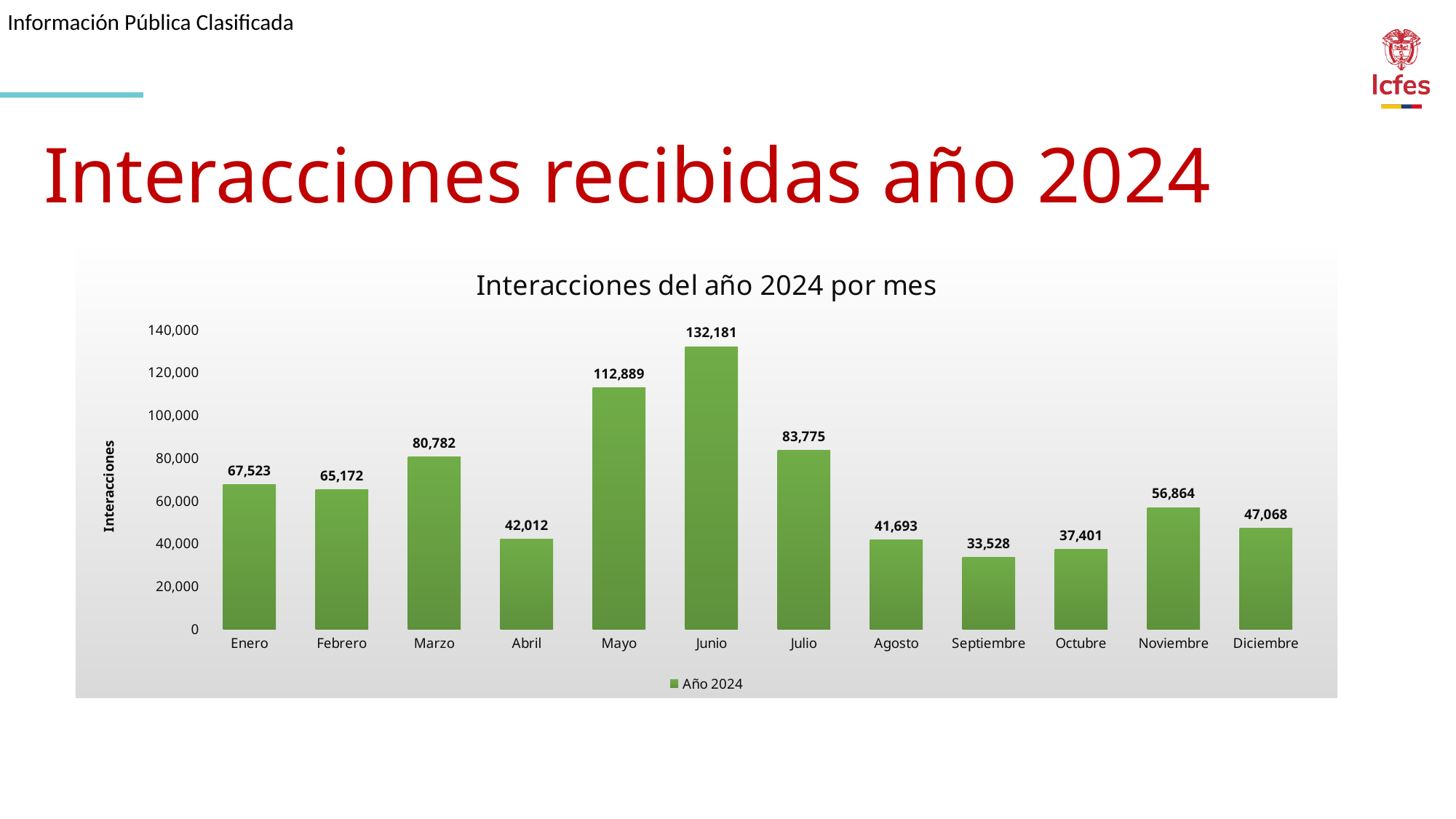
Which month has the lowest value? Septiembre What is the difference between the values for Junio and Mayo? 19,292 How many months are shown on the x axis? 12 What is the difference between the values for Marzo and Febrero? 15,610 What is the value for Junio? 132,181 What is the title of the chart? Interacciones del año 2024 por mes Which month has the highest value? Junio What is the value for Septiembre? 33,528 What kind of chart is shown on the slide? Bar chart Which is larger, the value for Julio or the value for Marzo? Julio Is the value for Mayo greater or less than 100,000? greater What is the value for Noviembre? 56,864